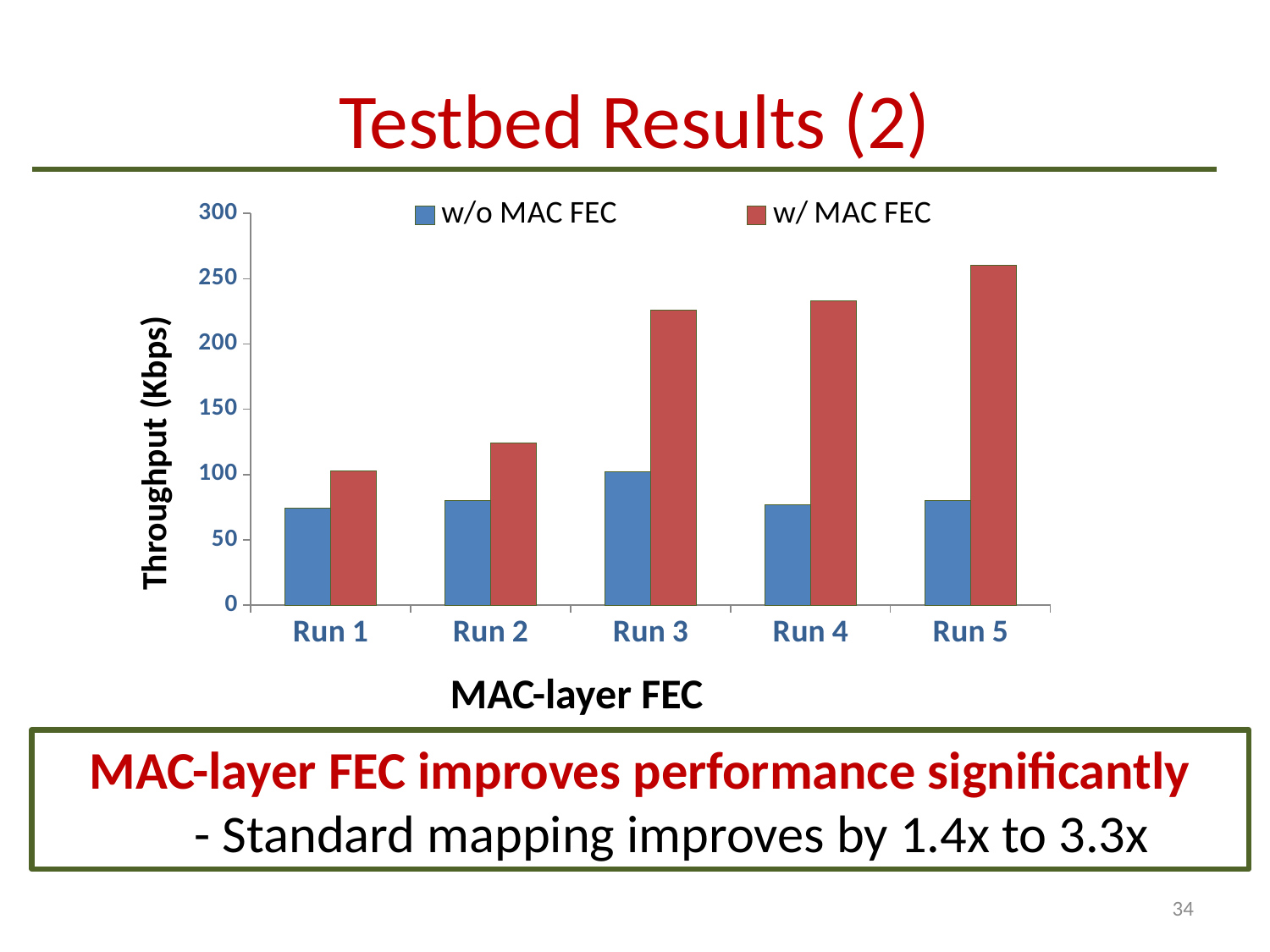
How many series does the legend list? 2 Which run has the lowest throughput for the w/ MAC FEC series? Run 1 Is the w/o MAC FEC throughput for Run 1 greater or less than 100? less How many runs are shown on the x axis? 5 Which is larger for Run 3: the w/o MAC FEC throughput or the w/ MAC FEC throughput? w/ MAC FEC Which run has the highest throughput for the w/ MAC FEC series? Run 5 What kind of chart is shown on the slide? bar chart Which run has the highest throughput for the w/o MAC FEC series? Run 3 Is the w/ MAC FEC throughput for Run 3 greater or less than 200? greater Is the w/ MAC FEC throughput for Run 5 greater or less than 250? greater Does the w/ MAC FEC throughput rise or fall from Run 1 to Run 5? rise What is the label of the y axis? Throughput (Kbps)